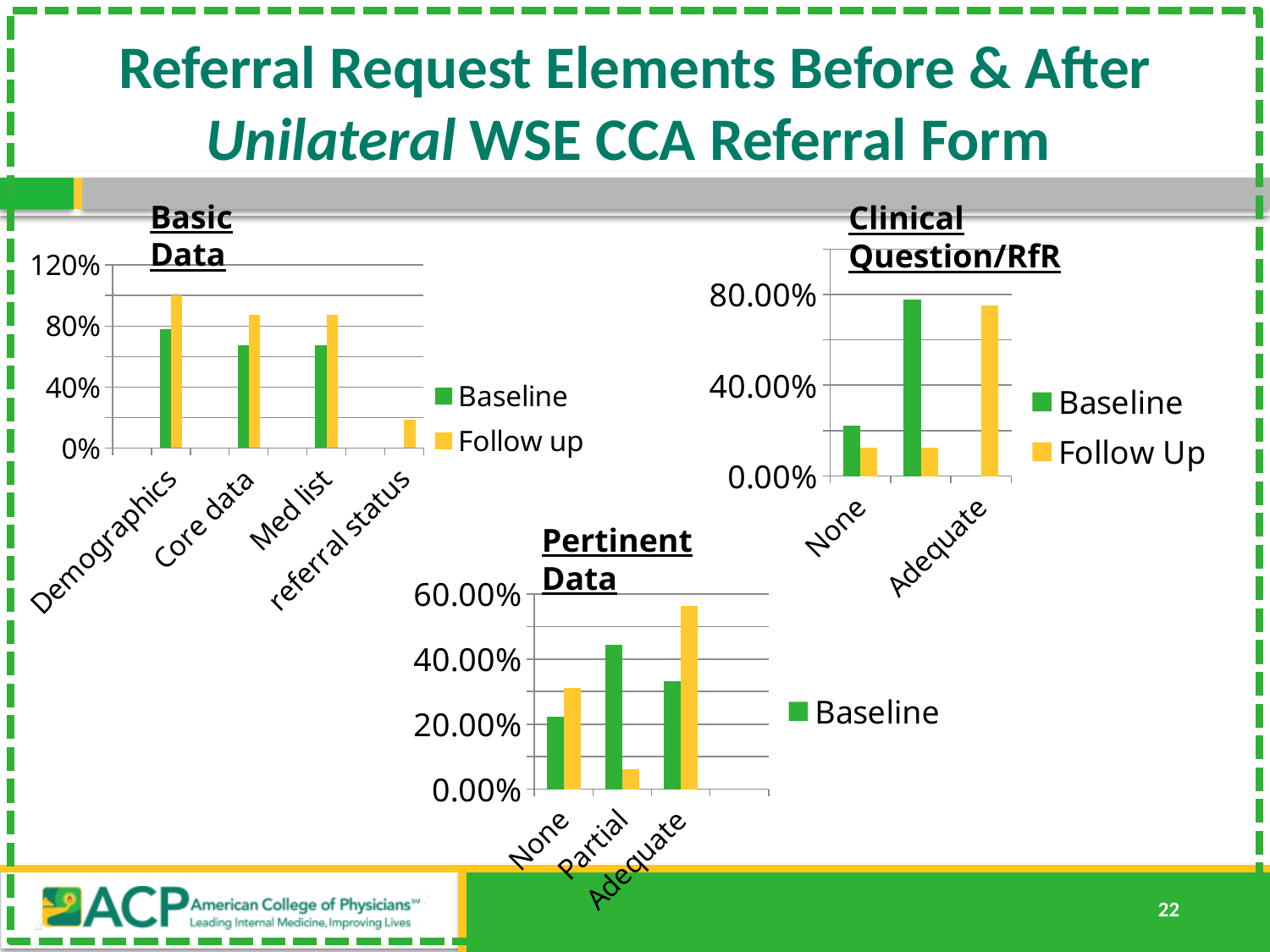
In the Basic Data chart, is the Follow up value for Demographics greater or less than 80%? greater In the Clinical Question/RfR chart, is the Baseline value for None greater or less than 40.00%? less In the Basic Data chart, is the Follow up value for referral status greater or less than 40%? less In the Basic Data chart, which is larger for Demographics, the Baseline value or the Follow up value? Follow up What kind of chart is the Basic Data chart? bar chart In the Pertinent Data chart, which category has the highest Baseline value? Partial How many series does the legend of the Pertinent Data chart list? 1 How many series does the legend of the Basic Data chart list? 2 How many categories are shown on the x axis of the Basic Data chart? 4 In the Basic Data chart, which category has the highest Follow up value? Demographics